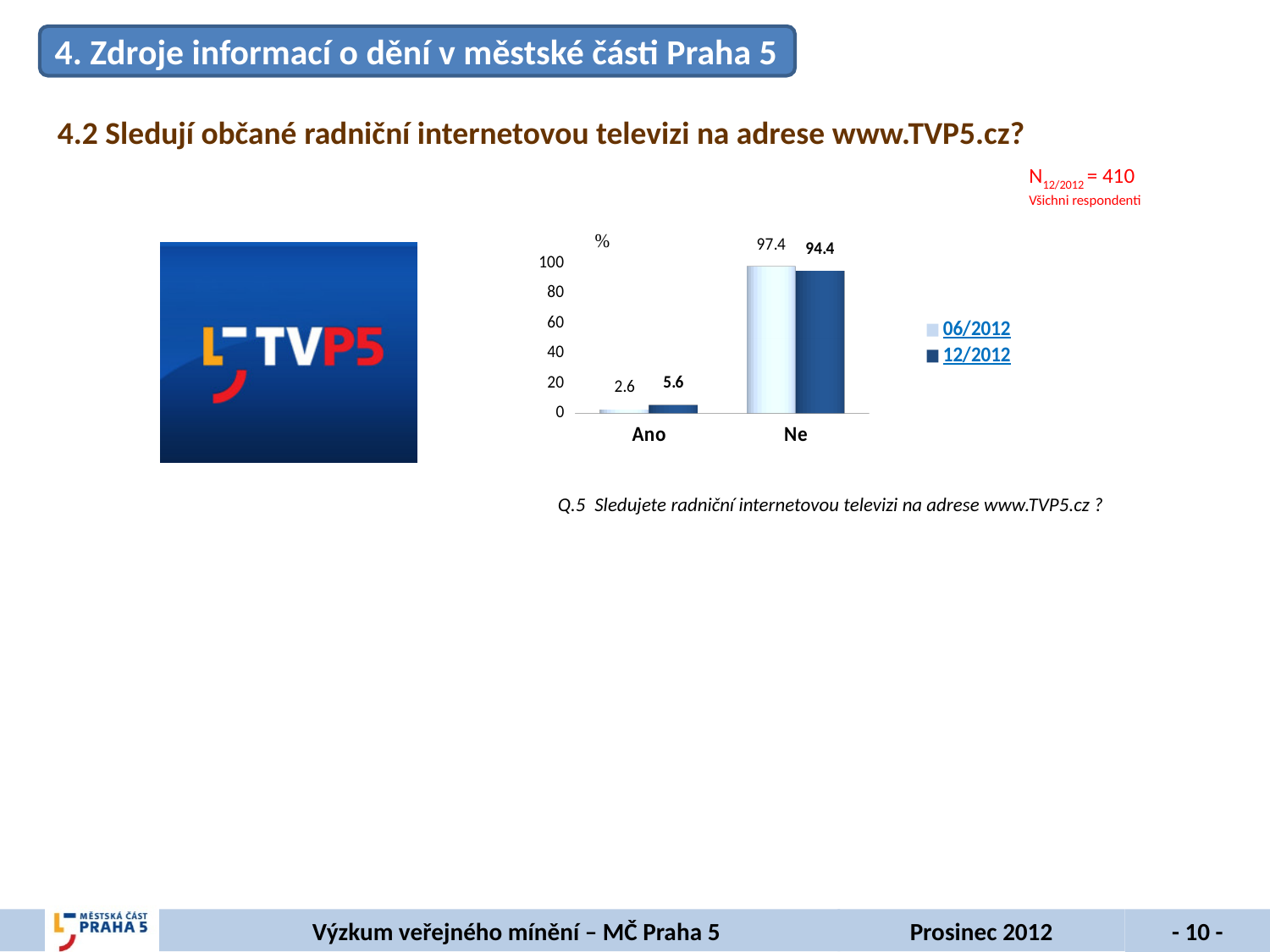
What is the difference between the 06/2012 and 12/2012 values for "Ne"? 3 What is the value for "Ano" in the 12/2012 series? 5.6 How many series does the legend list? 2 What is the value for "Ne" in the 12/2012 series? 94.4 Which category has the highest value in the 12/2012 series? Ne Which is larger for "Ano": the 06/2012 value or the 12/2012 value? 12/2012 What is the difference between the 12/2012 and 06/2012 values for "Ano"? 3 What is the value for "Ano" in the 06/2012 series? 2.6 Which category has the lowest value in the 06/2012 series? Ano How many categories are shown on the x axis? 2 What is the value for "Ne" in the 06/2012 series? 97.4 What kind of chart is shown on the slide? bar chart